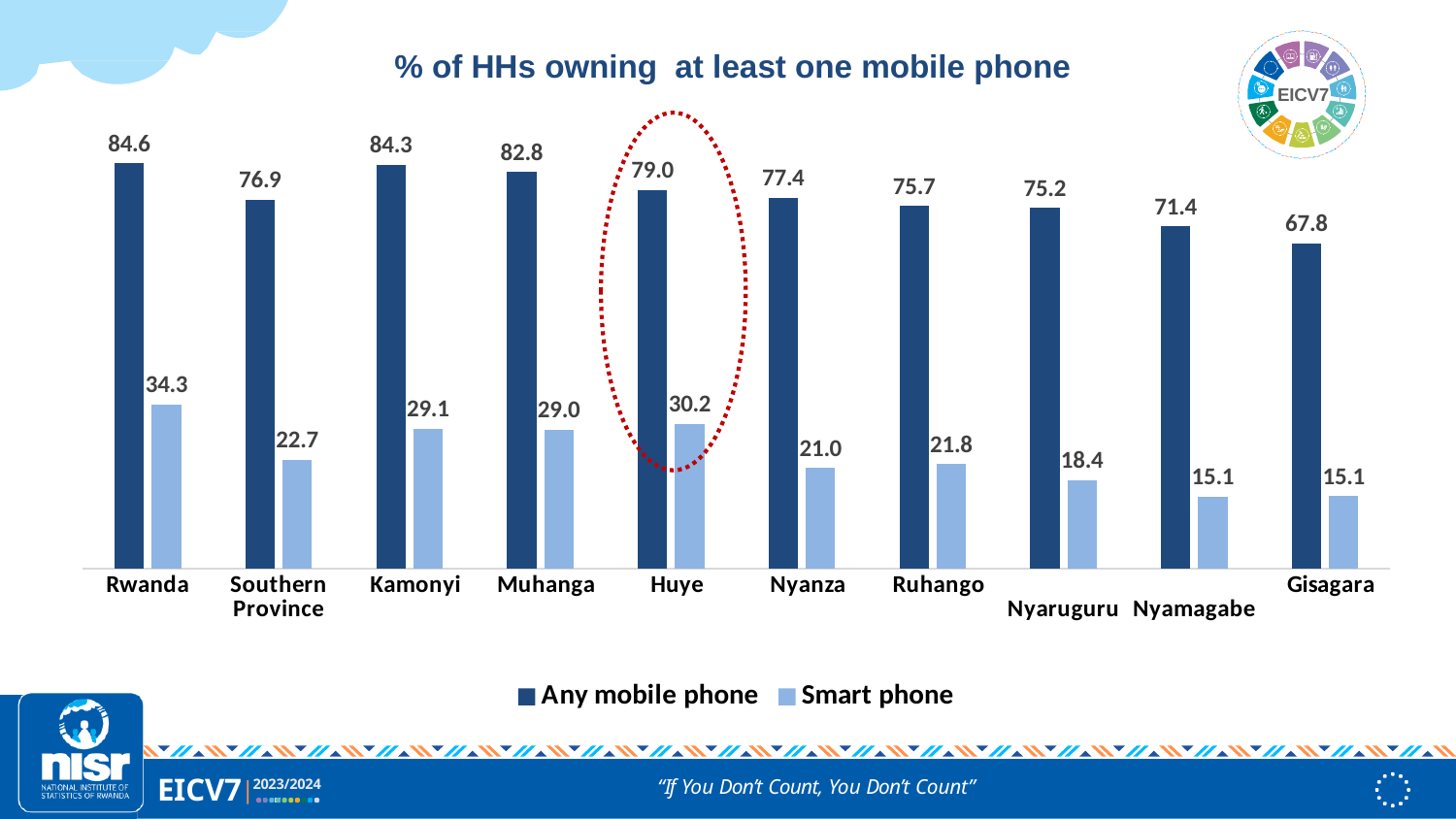
What is the Smart phone value for Southern Province? 22.7 From Kamonyi to Gisagara, do the Any mobile phone values rise or fall? Fall Which has a higher Smart phone value, Kamonyi or Nyanza? Kamonyi What kind of chart is shown on the slide? Bar chart What is the Any mobile phone value for Nyamagabe? 71.4 What is the difference between the Any mobile phone and Smart phone values for Huye? 48.8 Which category has the lowest Any mobile phone value? Gisagara What percentage of households in Huye own at least one mobile phone (Any mobile phone)? 79.0 Which category has the highest Smart phone value? Rwanda How many categories are shown on the x axis? 10 How many series does the legend list? 2 What is the Smart phone value for Nyaruguru? 18.4